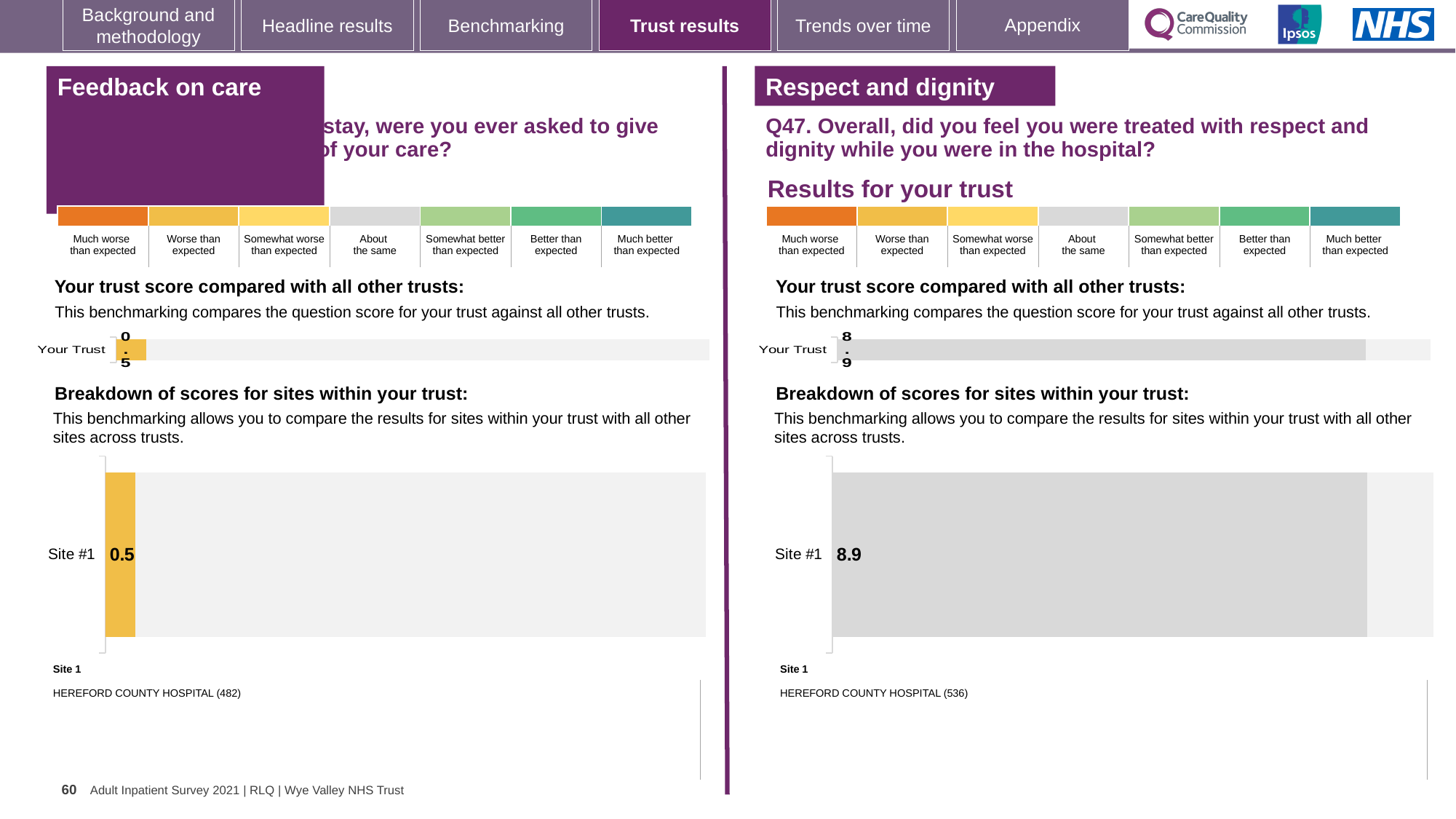
On the left-hand 'Feedback on care' section, what is the score shown for Your Trust? 0.5 Which hospital is listed as Site 1 beneath the left-hand 'Feedback on care' chart? HEREFORD COUNTY HOSPITAL (482) Which hospital is listed as Site 1 beneath the right-hand 'Respect and dignity' chart? HEREFORD COUNTY HOSPITAL (536) What is the difference between the Site #1 score in the right-hand 'Respect and dignity' chart and the Site #1 score in the left-hand 'Feedback on care' chart? 8.4 In the right-hand site breakdown chart under 'Respect and dignity', what score is shown for Site #1? 8.9 How many sites are shown in the left-hand site breakdown chart under 'Feedback on care'? 1 In the left-hand site breakdown chart under 'Feedback on care', what score is shown for Site #1? 0.5 On the right-hand 'Respect and dignity' section, what is the score shown for Your Trust? 8.9 How many sites are shown in the right-hand site breakdown chart under 'Respect and dignity'? 1 What type of chart is used for the Site #1 breakdown under 'Respect and dignity'? Bar chart Which is larger: the Site #1 score in the left-hand 'Feedback on care' chart or the Site #1 score in the right-hand 'Respect and dignity' chart? Respect and dignity (8.9) What type of chart is used for the Site #1 breakdown under 'Feedback on care'? Bar chart